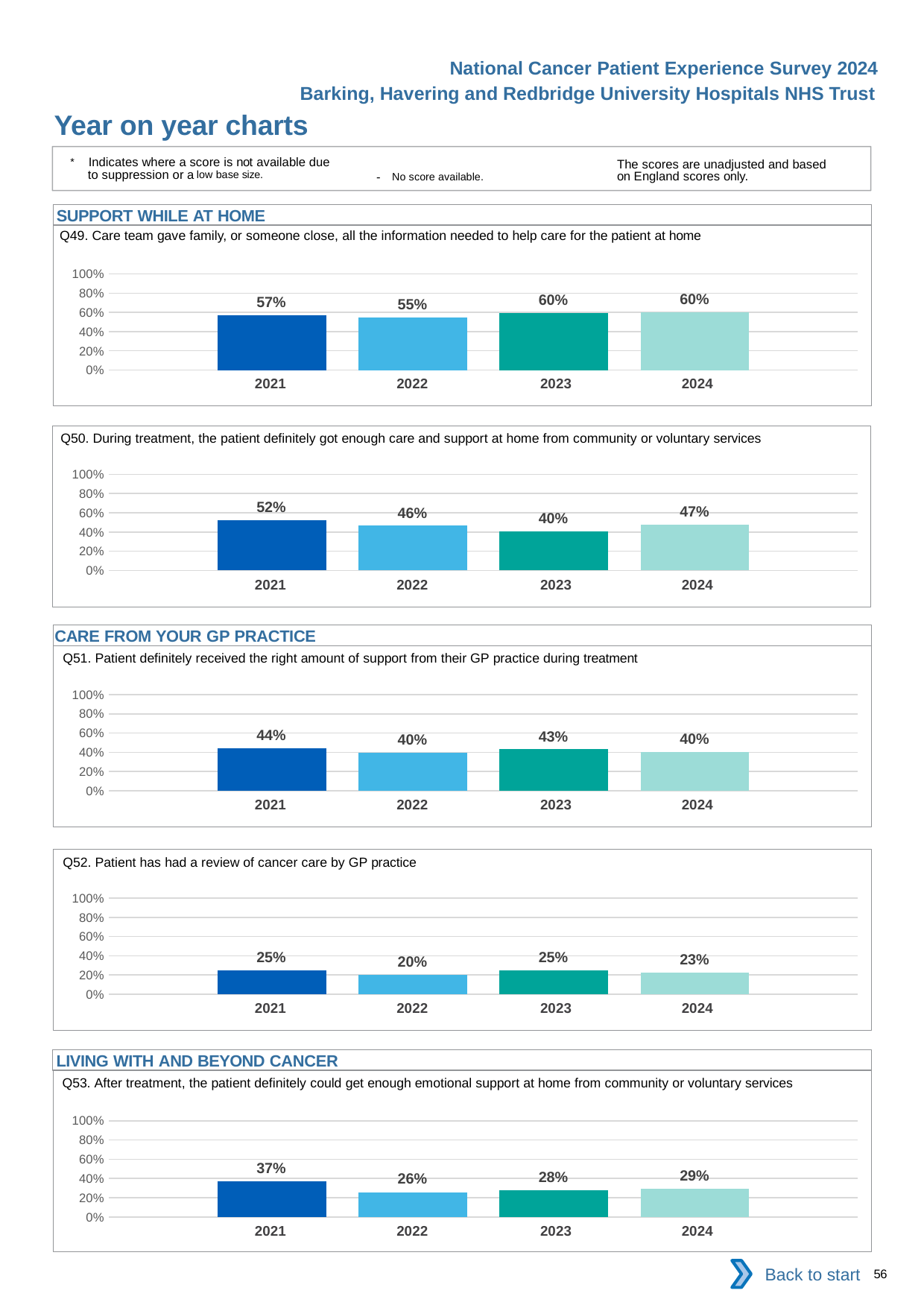
In the Q49 chart, what is the value for 2021? 57% In the Q49 chart, what is the value for 2024? 60% In the Q53 chart, what is the difference between the 2021 and 2022 values? 11% In the Q53 chart, is the value for 2021 greater or less than 40%? less What kind of chart is used for Q50? Bar chart In the Q50 chart, which year has the lowest value? 2023 In the Q51 chart, what is the value for 2023? 43% In the Q52 chart, which is larger, the value for 2022 or the value for 2024? 2024 How many years are shown in the Q49 chart? 4 In the Q52 chart, what is the value for 2022? 20% In the Q50 chart, what is the difference between the 2021 and 2024 values? 5% In the Q51 chart, which year has the highest value? 2021